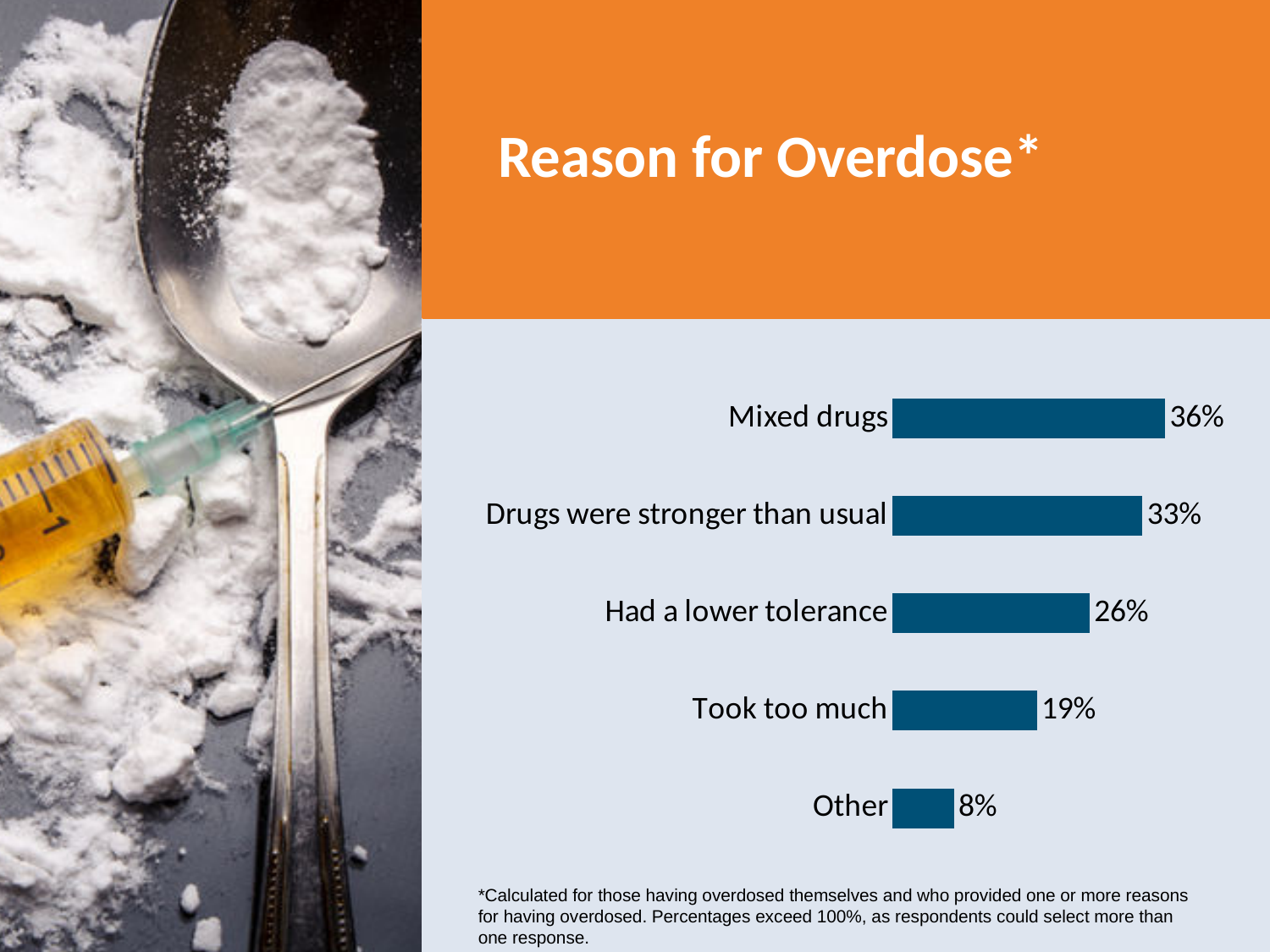
What percentage is shown for "Mixed drugs"? 36% What percentage is shown for "Other"? 8% Which reason for overdose has the lowest percentage? Other How many reasons for overdose are shown in the chart? 5 What is the title of the chart on the slide? Reason for Overdose* What percentage is shown for "Took too much"? 19% Which reason for overdose has the highest percentage? Mixed drugs What is the difference in percentage points between "Had a lower tolerance" and "Other"? 18 Which is larger, the value for "Took too much" or the value for "Had a lower tolerance"? Had a lower tolerance What is the difference in percentage points between "Mixed drugs" and "Drugs were stronger than usual"? 3 What kind of chart is shown on the slide? Bar chart What percentage is shown for "Had a lower tolerance"? 26%